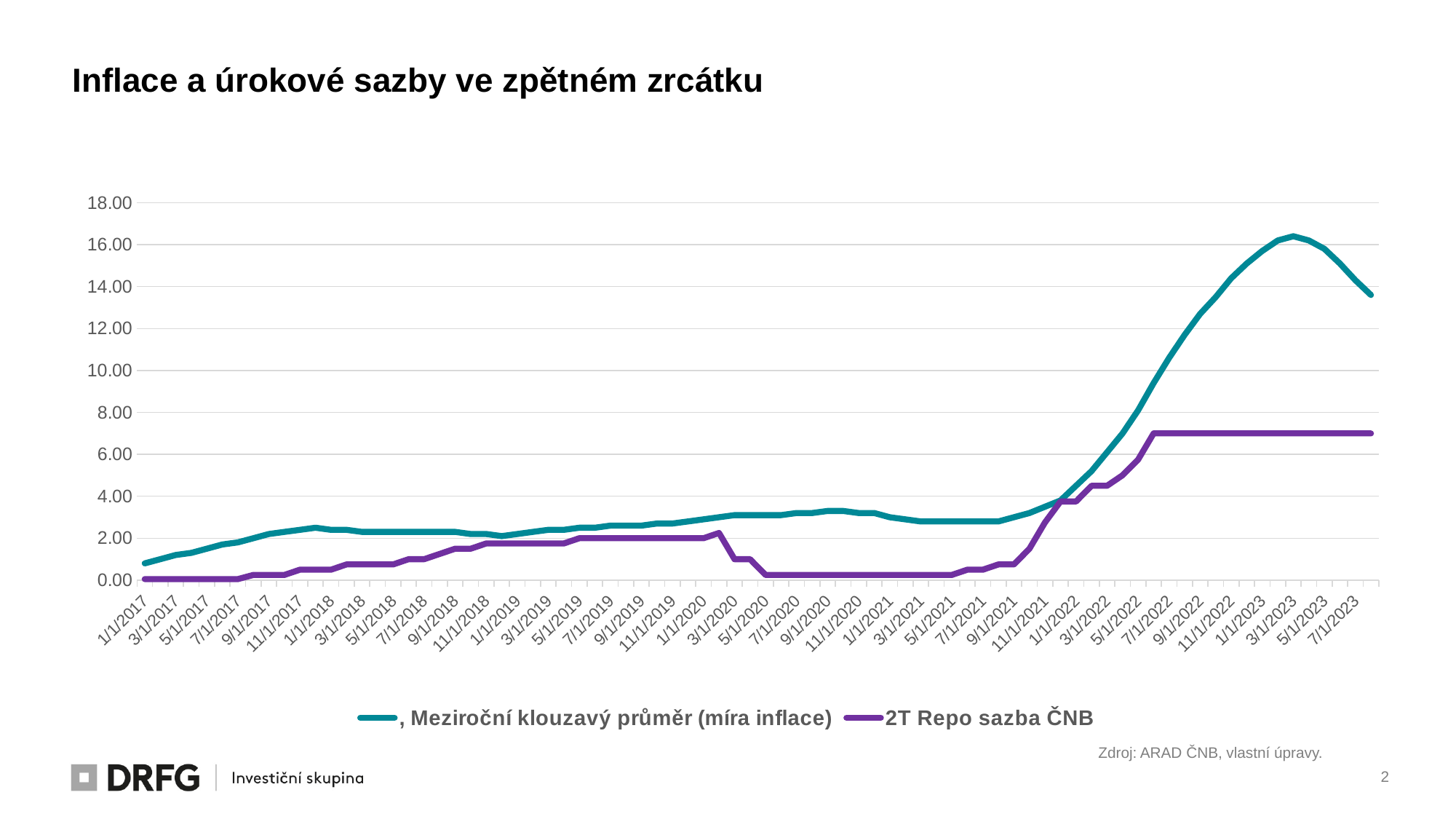
Is the value of the inflation series (Meziroční klouzavý průměr) at 7/1/2023 greater or less than 12.00? greater What is the title of the chart on the slide? Inflace a úrokové sazby ve zpětném zrcátku Is the value of the 2T Repo sazba ČNB series at 1/1/2023 greater or less than 6.00? greater What kind of chart is shown on the slide? line chart Which series reaches the highest value anywhere on the chart? Meziroční klouzavý průměr (míra inflace) Is the value of the inflation series (Meziroční klouzavý průměr) at 3/1/2023 greater or less than 14.00? greater At 7/1/2020, which series has the higher value: the inflation series or 2T Repo sazba ČNB? Meziroční klouzavý průměr (míra inflace) What is the name of the second series in the legend? 2T Repo sazba ČNB How many series does the legend list? 2 Does the inflation series (Meziroční klouzavý průměr) rise or fall between 3/1/2023 and 7/1/2023? fall